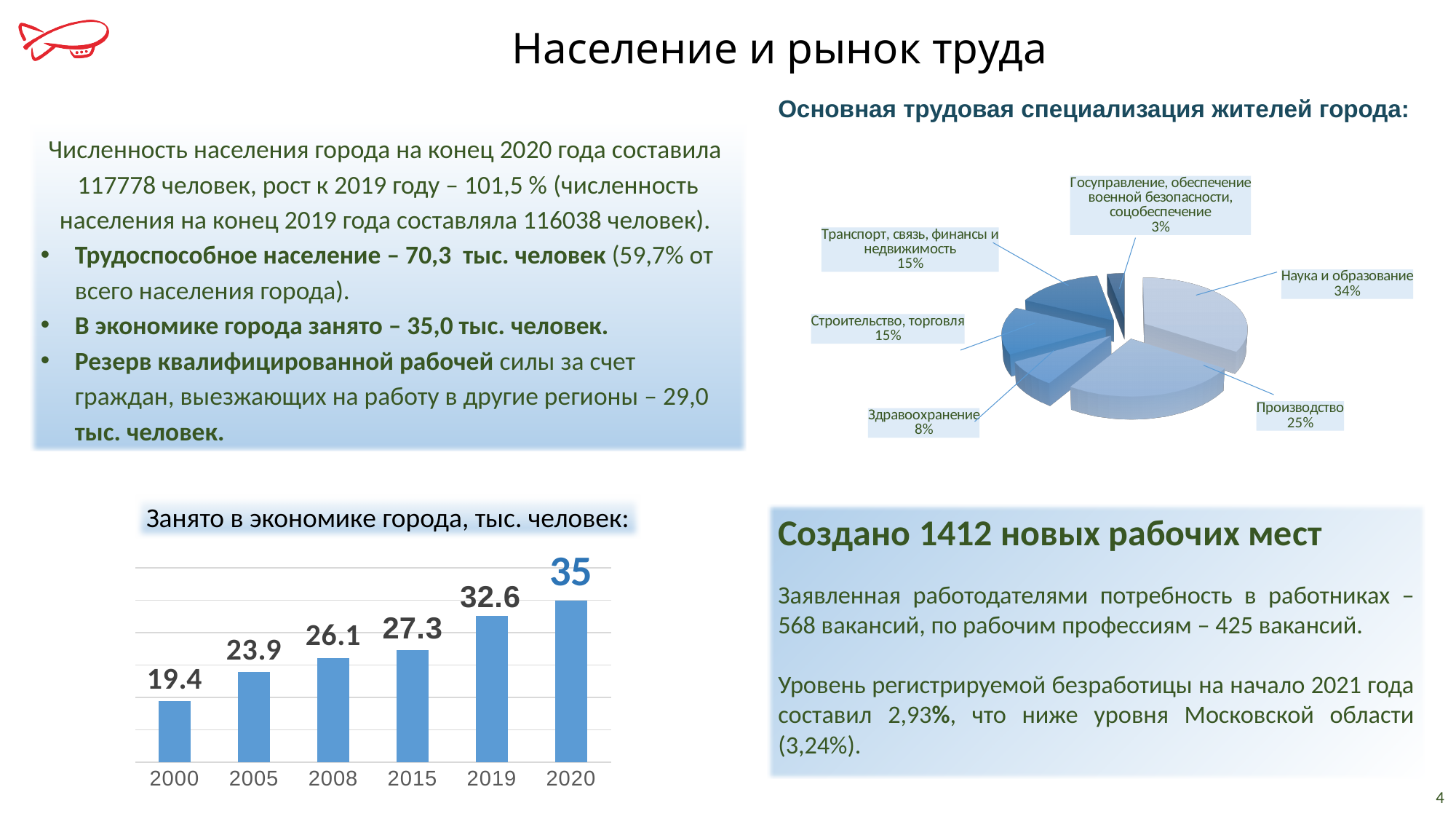
In the bar chart 'Занято в экономике города, тыс. человек', which year has the lowest value? 2000 What kind of chart is 'Занято в экономике города, тыс. человек'? bar chart In the pie chart 'Основная трудовая специализация жителей города', which category has the smallest share? Госуправление, обеспечение военной безопасности, соцобеспечение In the bar chart 'Занято в экономике города, тыс. человек', how many years are shown on the x axis? 6 In the pie chart 'Основная трудовая специализация жителей города', what share does 'Наука и образование' have? 34% In the bar chart 'Занято в экономике города, тыс. человек', do the values rise or fall from 2000 to 2020? rise In the pie chart 'Основная трудовая специализация жителей города', how many categories are shown? 6 In the bar chart 'Занято в экономике города, тыс. человек', which year has the highest value? 2020 In the bar chart 'Занято в экономике города, тыс. человек', what is the value for 2020? 35 In the bar chart 'Занято в экономике города, тыс. человек', what is the difference between the values for 2019 and 2015? 5.3 In the pie chart 'Основная трудовая специализация жителей города', which is larger: 'Производство' or 'Здравоохранение'? Производство In the bar chart 'Занято в экономике города, тыс. человек', what is the value for 2000? 19.4